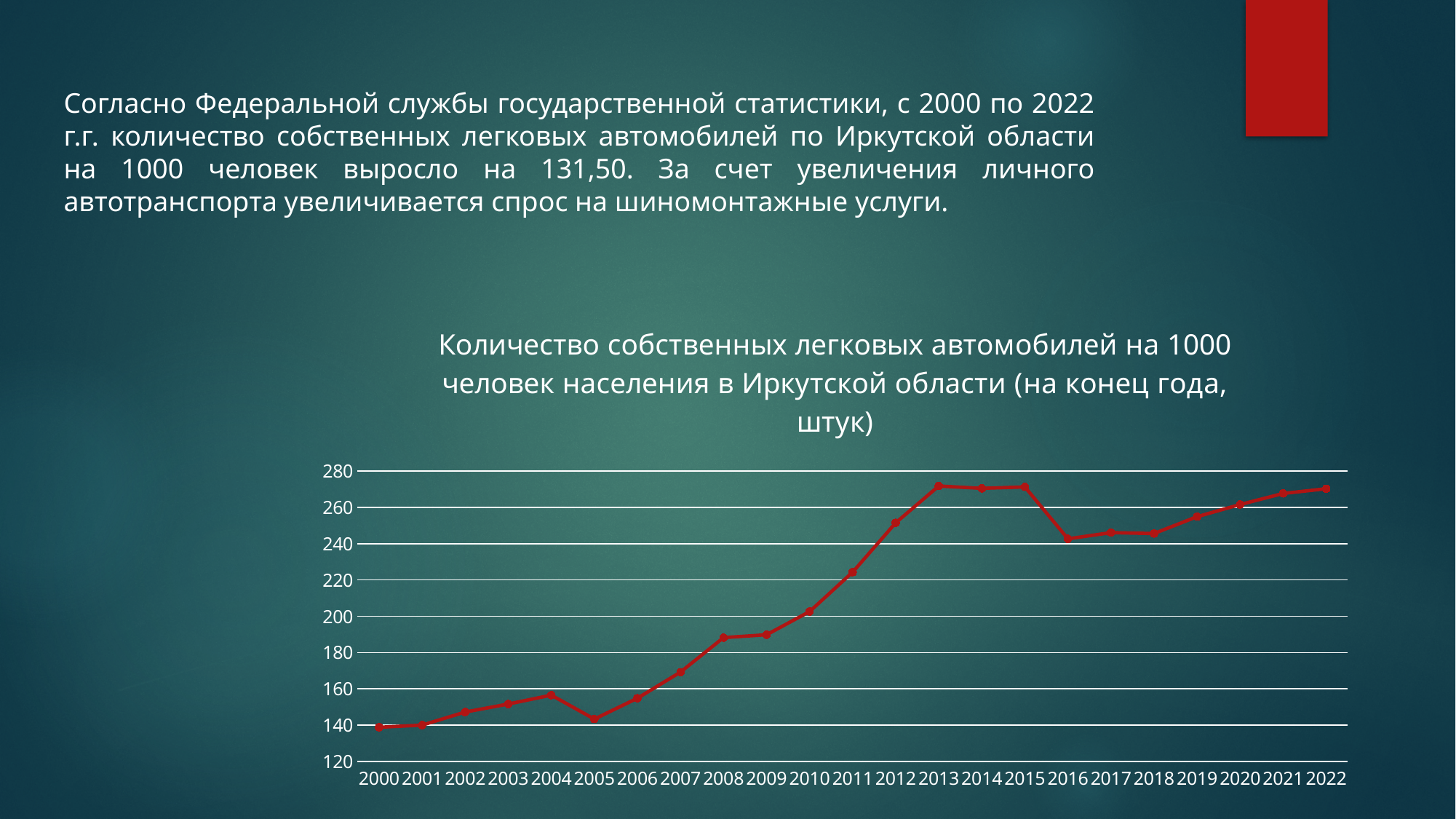
Is the value for 2016 greater or less than 260? less Is the value for 2005 greater or less than 160? less Is the value for 2007 greater or less than 180? less What is the first year shown on the x axis of the chart? 2000 How many years (data points) are plotted on the x axis of the chart? 23 Overall, do the values rise or fall from 2000 to 2022? rise What kind of chart is shown on the slide? line chart Which year has the larger value, 2011 or 2016? 2016 What colour is the line in the chart? red Which year has the larger value, 2004 or 2005? 2004